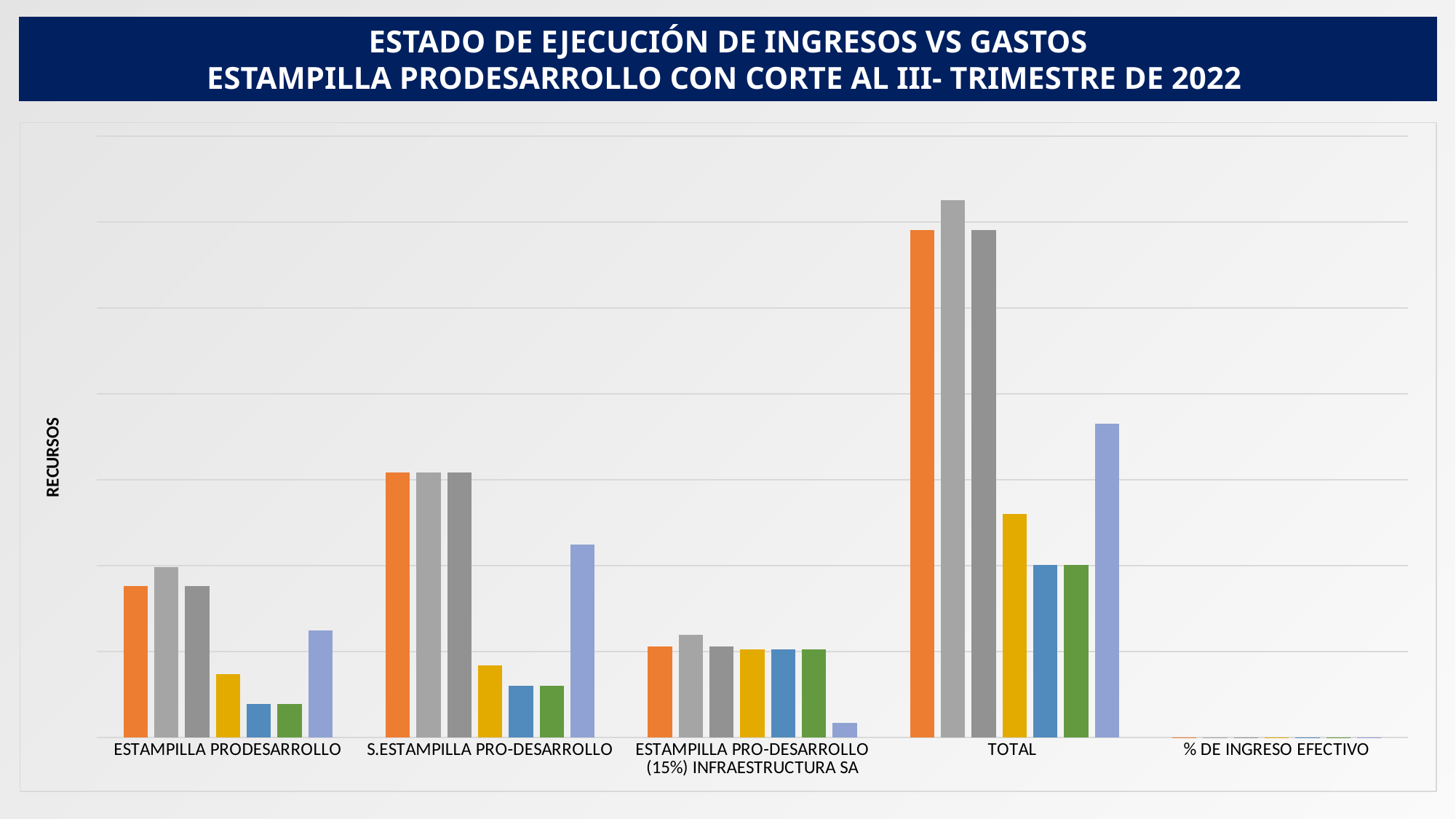
Within the TOTAL category, is the light gray bar or the yellow bar taller? light gray What kind of chart is shown on the slide? bar chart Is the orange bar taller for TOTAL or for ESTAMPILLA PRO-DESARROLLO (15%) INFRAESTRUCTURA SA? TOTAL What colour is the first bar in each category group? orange Which category has the tallest bars in the chart? TOTAL Is the orange bar taller for S.ESTAMPILLA PRO-DESARROLLO or for ESTAMPILLA PRODESARROLLO? S.ESTAMPILLA PRO-DESARROLLO Which category has the lowest values in the chart? % DE INGRESO EFECTIVO How many categories are shown along the x axis of the chart? 5 How many bars are plotted for the TOTAL category? 7 What is the label on the vertical axis of the chart? RECURSOS